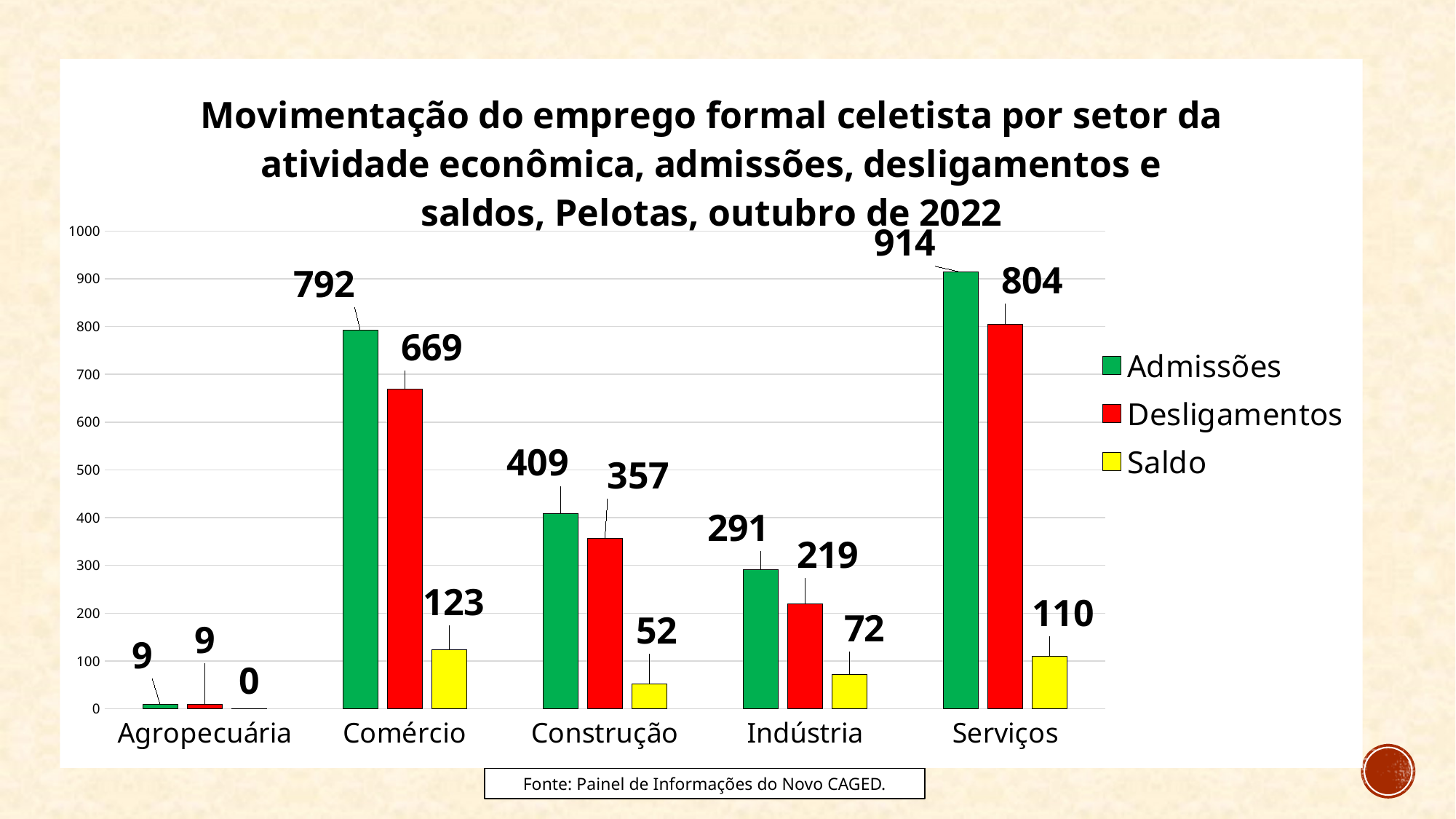
What is the difference between Admissões and Desligamentos for Indústria? 72 Is the value of Desligamentos for Comércio greater or less than 600? greater Which sector has the lowest Saldo? Agropecuária How many series does the legend list? 3 How many sectors are shown on the x axis? 5 What colour represents the Saldo series? Yellow What kind of chart is shown on the slide? Bar chart What is the value of Admissões for Comércio? 792 Which sector has the highest value for Admissões? Serviços What is the value of Desligamentos for Serviços? 804 What is the Saldo for Construção? 52 Which is larger for Construção: Admissões or Desligamentos? Admissões